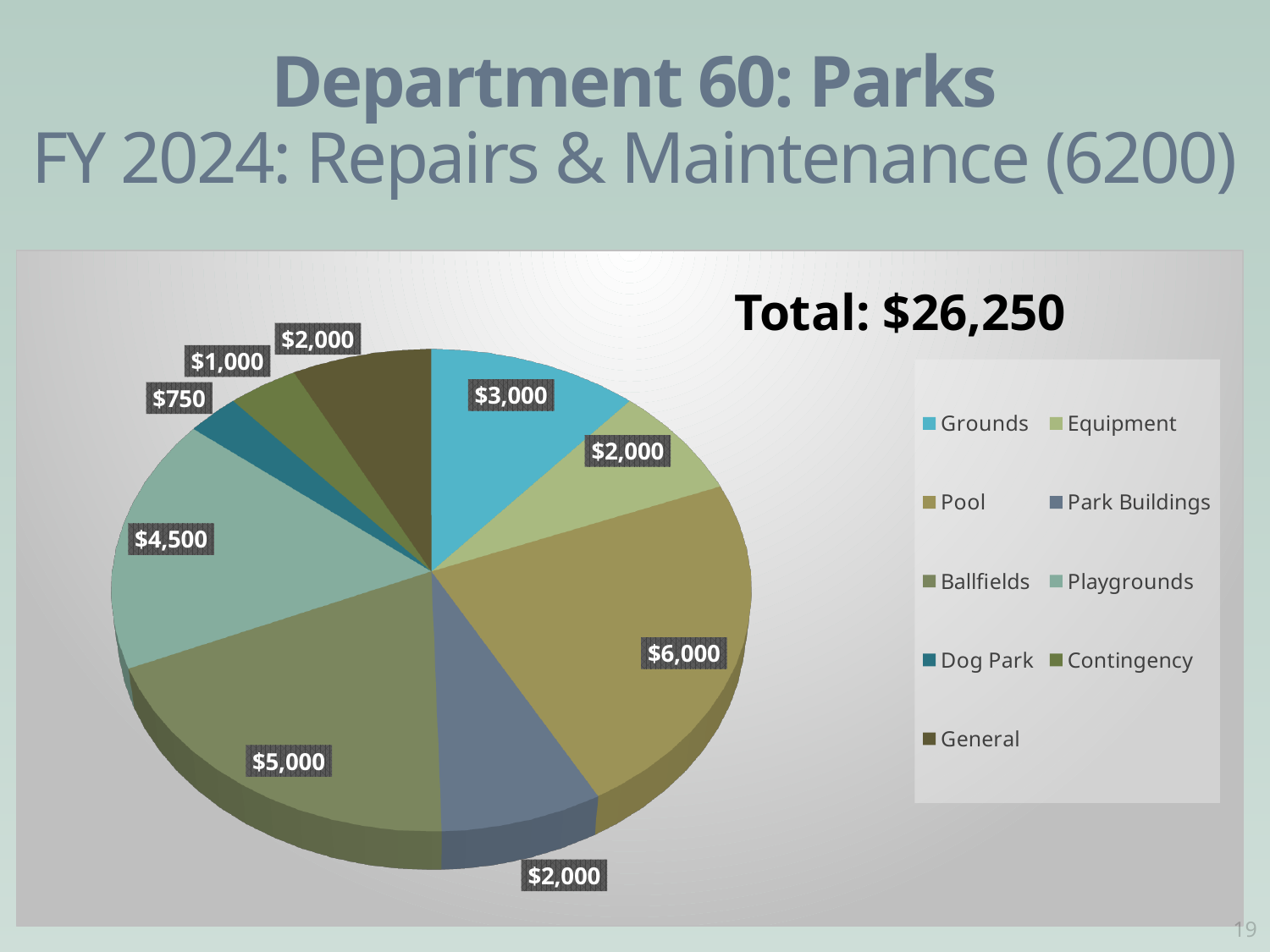
What is the difference between the values for Playgrounds and Grounds? $1,500 Which category has the smallest slice of the pie? Dog Park What is the value for Grounds? $3,000 What total is stated on the chart? $26,250 What is the value for Pool? $6,000 What is the difference between the values for Pool and Ballfields? $1,000 What is the value for Playgrounds? $4,500 Which category has the largest slice of the pie? Pool How many categories are shown in the pie chart? 9 What kind of chart is shown on the slide? Pie chart Which is larger, the value for Grounds or the value for Equipment? Grounds What is the value for Dog Park? $750